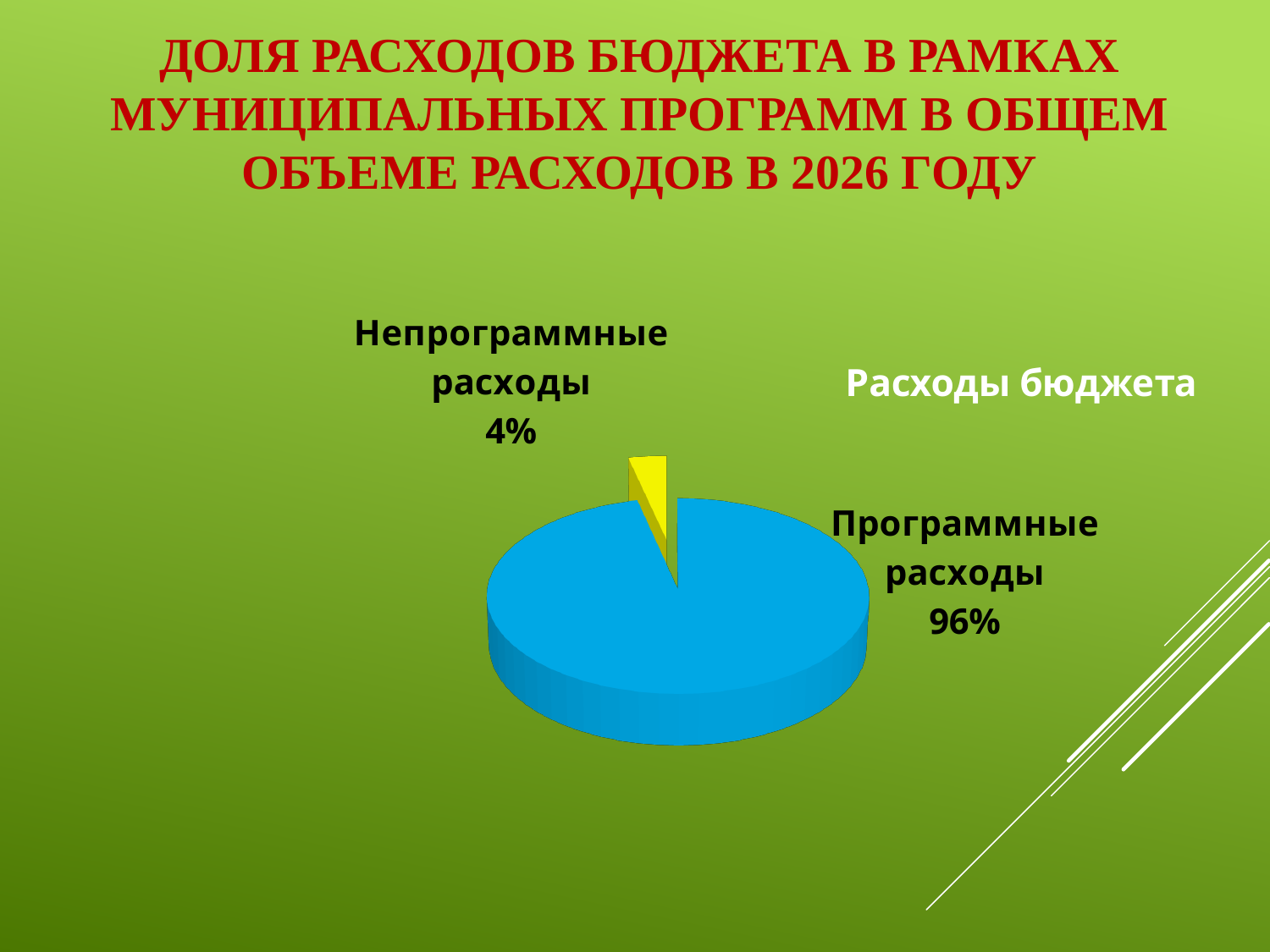
What share of the pie is labelled "Непрограммные расходы"? 4% What kind of chart is shown on the slide? pie chart How many slices does the pie chart have? 2 What is the difference in percentage points between "Программные расходы" and "Непрограммные расходы"? 92 What is the total of the two slices shown in the pie chart? 100% Which slice of the pie is the largest? Программные расходы Which is larger: "Программные расходы" or "Непрограммные расходы"? Программные расходы What is the title of the chart? Расходы бюджета What share of the pie is labelled "Программные расходы"? 96% What colour is the slice for "Непрограммные расходы"? yellow Which slice of the pie is the smallest? Непрограммные расходы